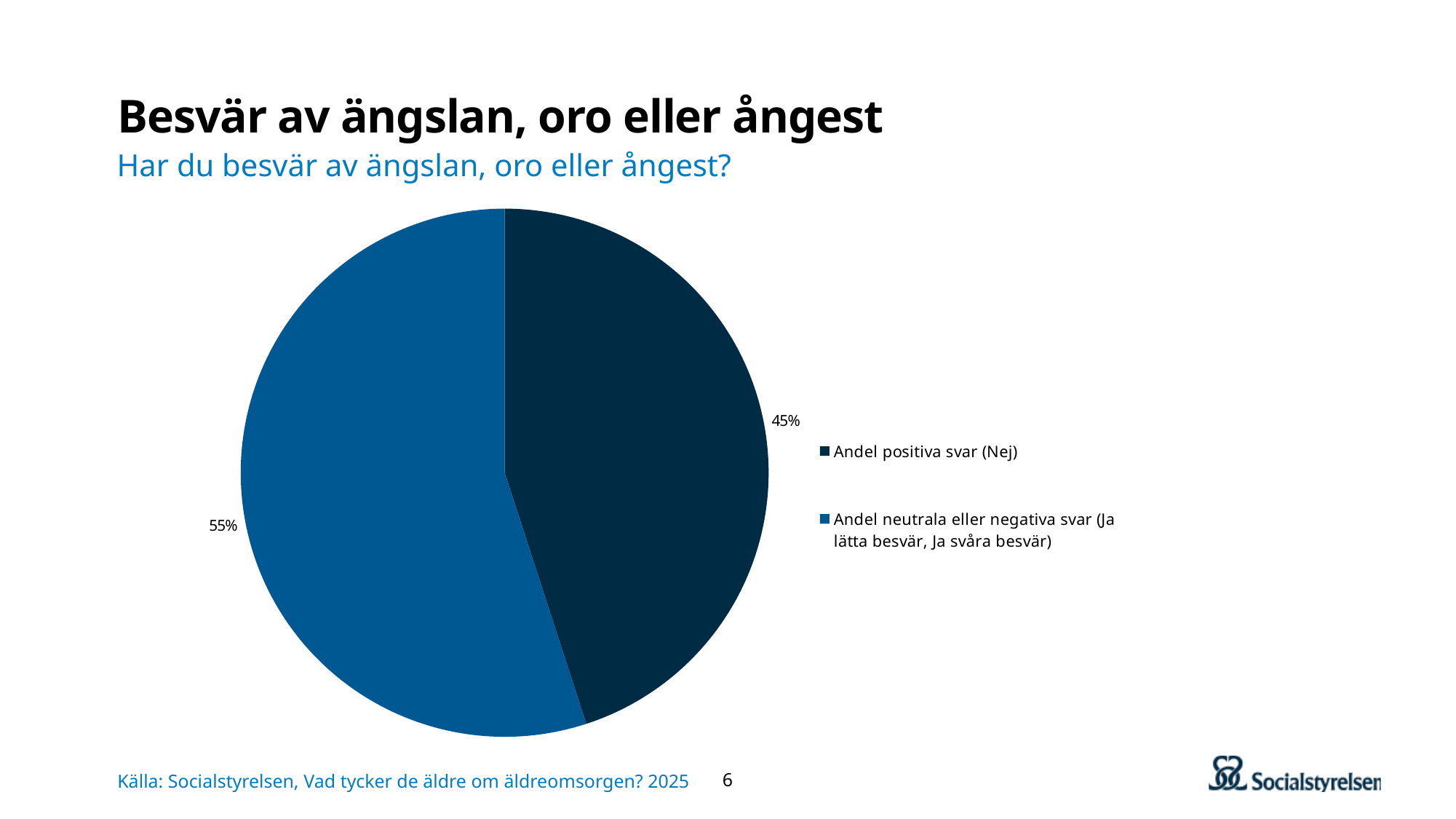
Which slice is the smallest? Andel positiva svar (Nej) What kind of chart is shown on the slide? pie chart What is the difference in percentage points between the two slices? 10 percentage points How many slices does the pie chart have? 2 Which is larger: the share of positive answers (Nej) or the share of neutral or negative answers? Andel neutrala eller negativa svar (Ja lätta besvär, Ja svåra besvär) What question is shown as the subtitle above the chart? Har du besvär av ängslan, oro eller ångest? What is the total of the two slices shown? 100% What share of the pie is 'Andel neutrala eller negativa svar (Ja lätta besvär, Ja svåra besvär)'? 55% What share of the pie is 'Andel positiva svar (Nej)'? 45% How many entries does the legend list? 2 Which slice is the largest? Andel neutrala eller negativa svar (Ja lätta besvär, Ja svåra besvär) Which legend entry is shown in the darker navy colour? Andel positiva svar (Nej)